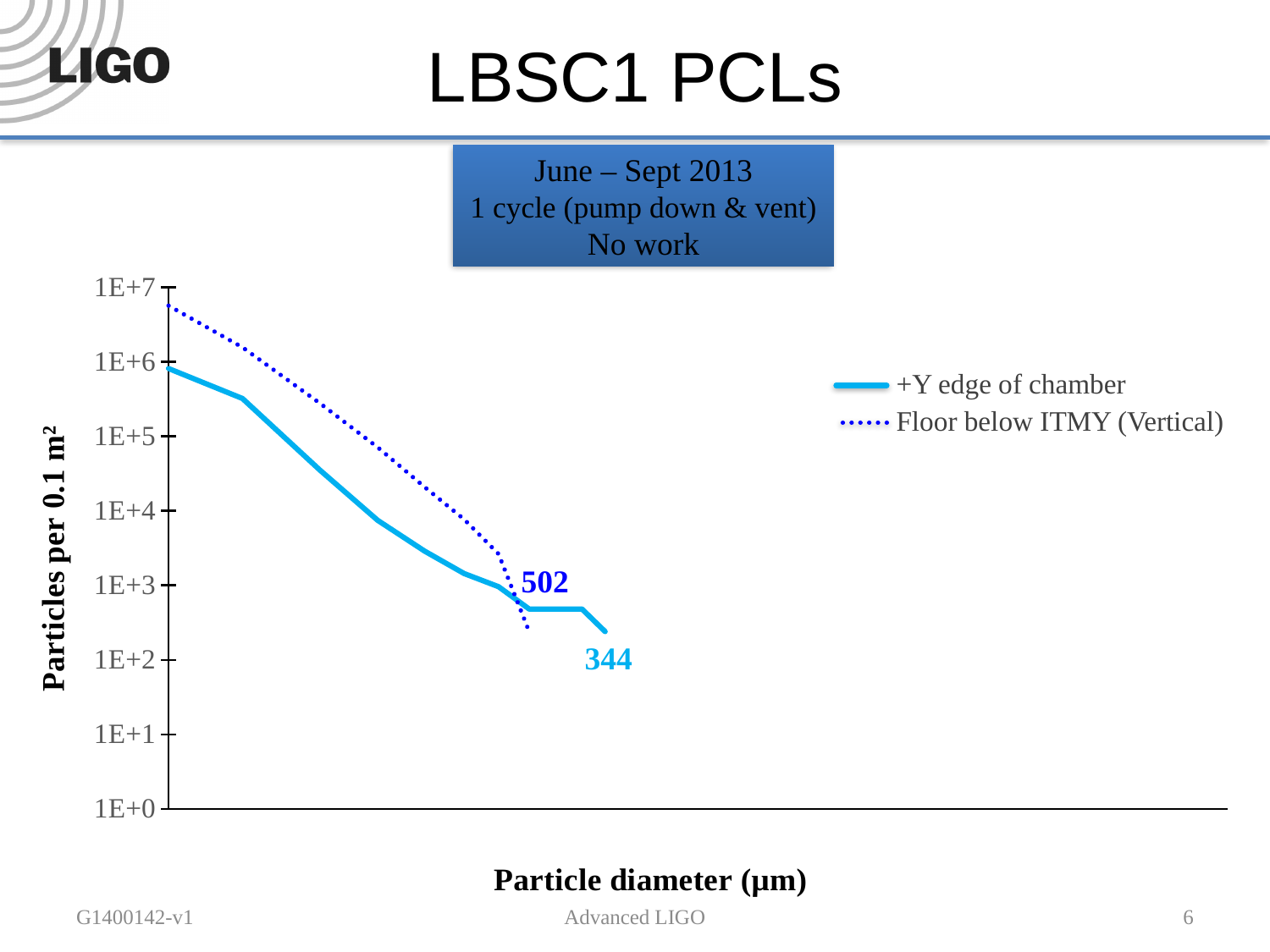
Do the values of the +Y edge of chamber series rise or fall as particle diameter increases? fall Is the starting value of the Floor below ITMY (Vertical) series greater or less than 1E+6? greater How many tick labels are shown on the y axis? 8 What kind of chart is shown on the slide? line chart What is the y-axis title of the chart? Particles per 0.1 m² At the left end of the chart, which series has the higher value: +Y edge of chamber or Floor below ITMY (Vertical)? Floor below ITMY (Vertical) How many series does the legend list? 2 Is the starting value of the +Y edge of chamber series greater or less than 1E+5? greater What number is annotated next to the end of the +Y edge of chamber line? 344 Is the final value of the Floor below ITMY (Vertical) series greater or less than 1E+3? less Do the values of the Floor below ITMY (Vertical) series rise or fall along the x axis? fall